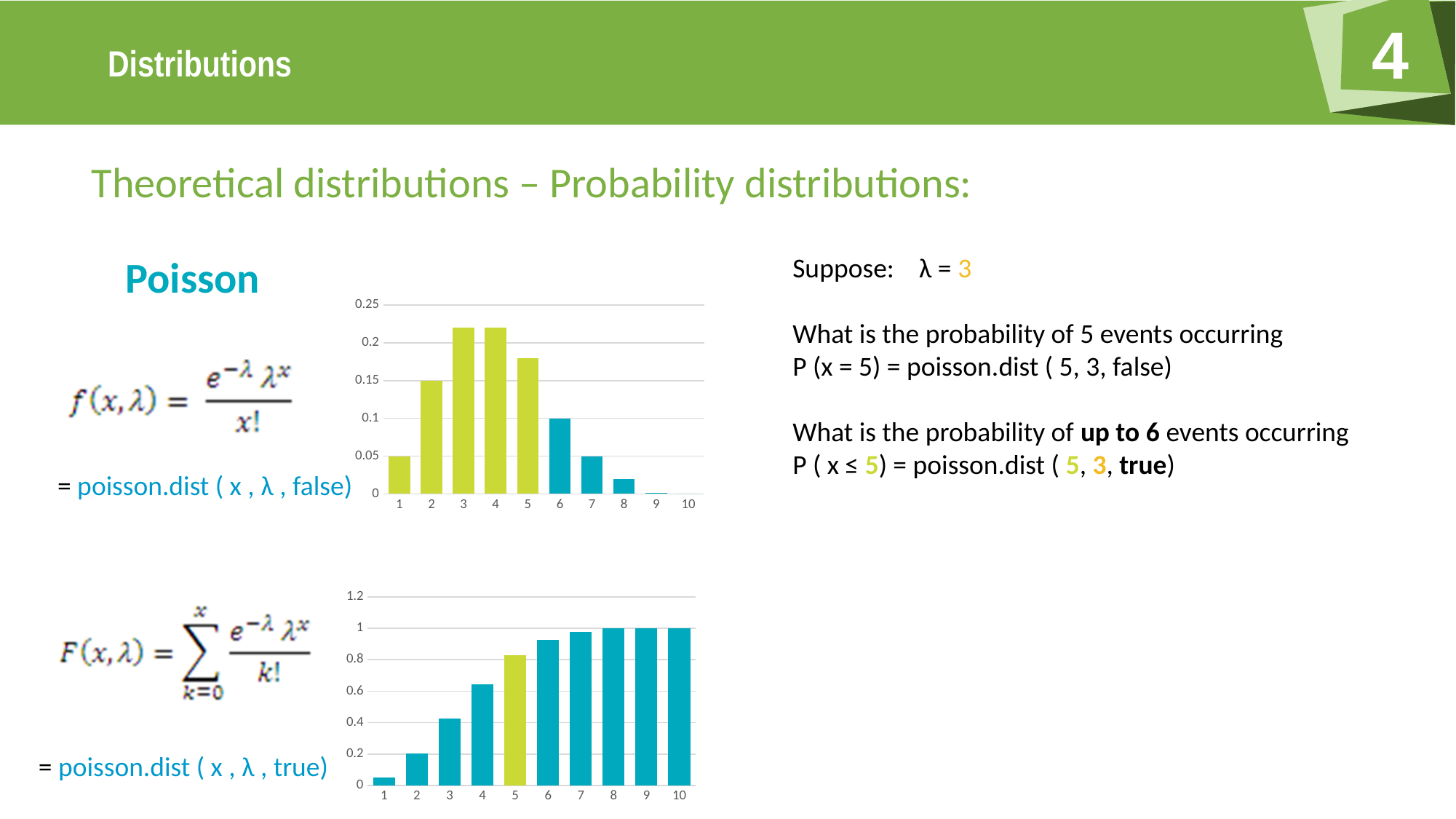
What kind of chart is the top chart on the slide? bar chart In the top chart, how many categories are shown on the x axis? 10 In the bottom chart, is the value for 3 greater or less than 0.6? less In the top chart, is the value for 5 greater or less than 0.15? greater In the bottom chart, which category has the lowest value? 1 In the top chart, how many bars are coloured green rather than blue? 5 In the top chart, which is larger, the value for 3 or the value for 6? 3 In the bottom chart, which bar is coloured green instead of blue? 5 In the bottom chart, do the values rise or fall as x increases from 1 to 10? rise In the bottom chart, what is the value for 9? 1 In the top chart, is the value for 8 greater or less than 0.05? less In the top chart, what is the value for 6? 0.1